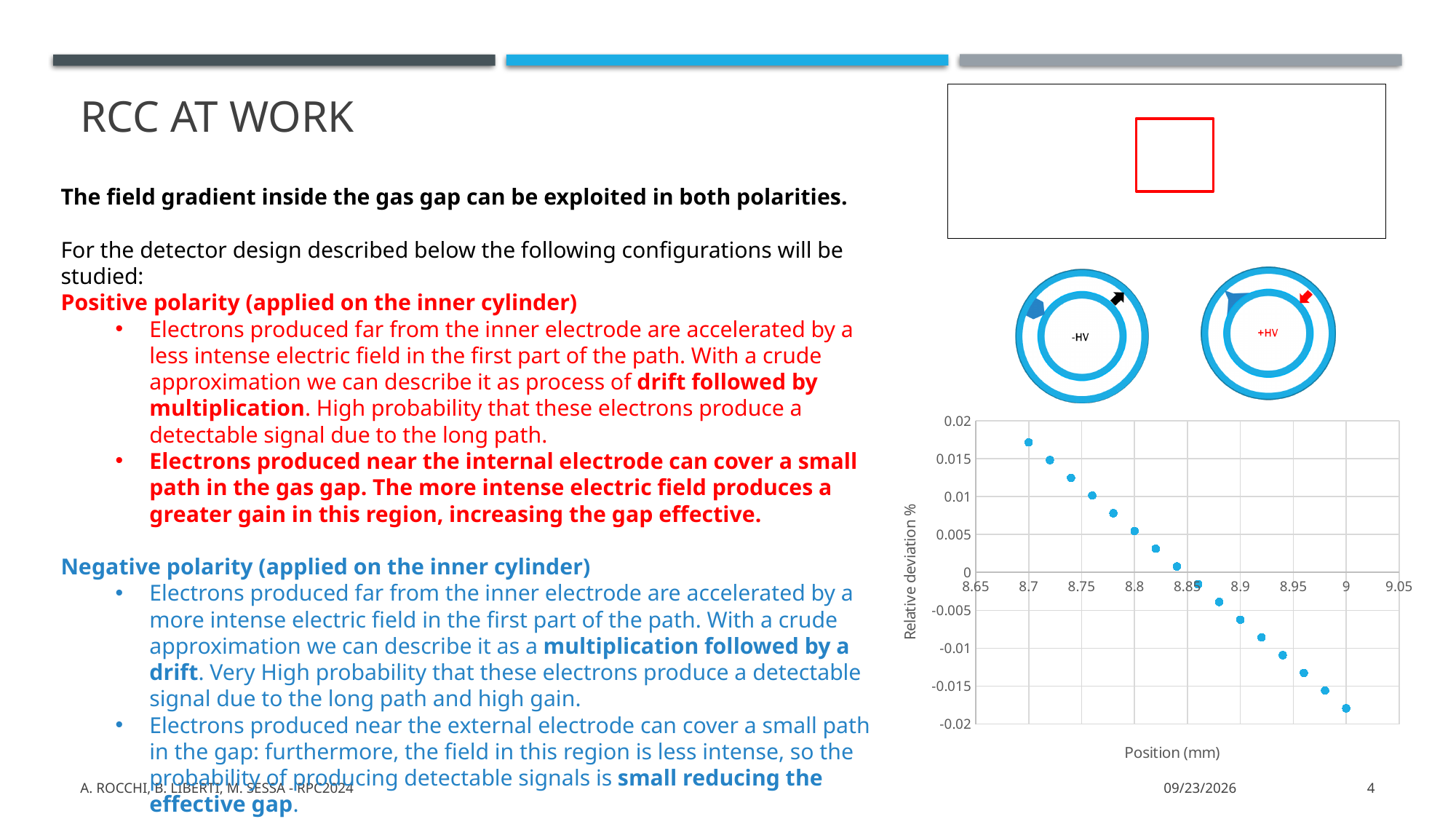
What is the title of the y axis of the chart? Relative deviation % Is the relative deviation at position 8.8 mm greater or less than 0? greater Is the relative deviation at position 8.9 mm greater or less than 0? less Do the plotted values rise or fall as position increases along the x axis? fall Is the relative deviation at position 9 mm greater or less than -0.015? less At which position (mm) is the relative deviation highest? 8.7 What kind of chart is shown on the slide? scatter plot At which position (mm) is the relative deviation lowest? 9 How many data points are plotted in the chart? 16 What is the title of the x axis of the chart? Position (mm) Which has the larger relative deviation: the point at 8.75 mm or the point at 8.95 mm? 8.75 mm